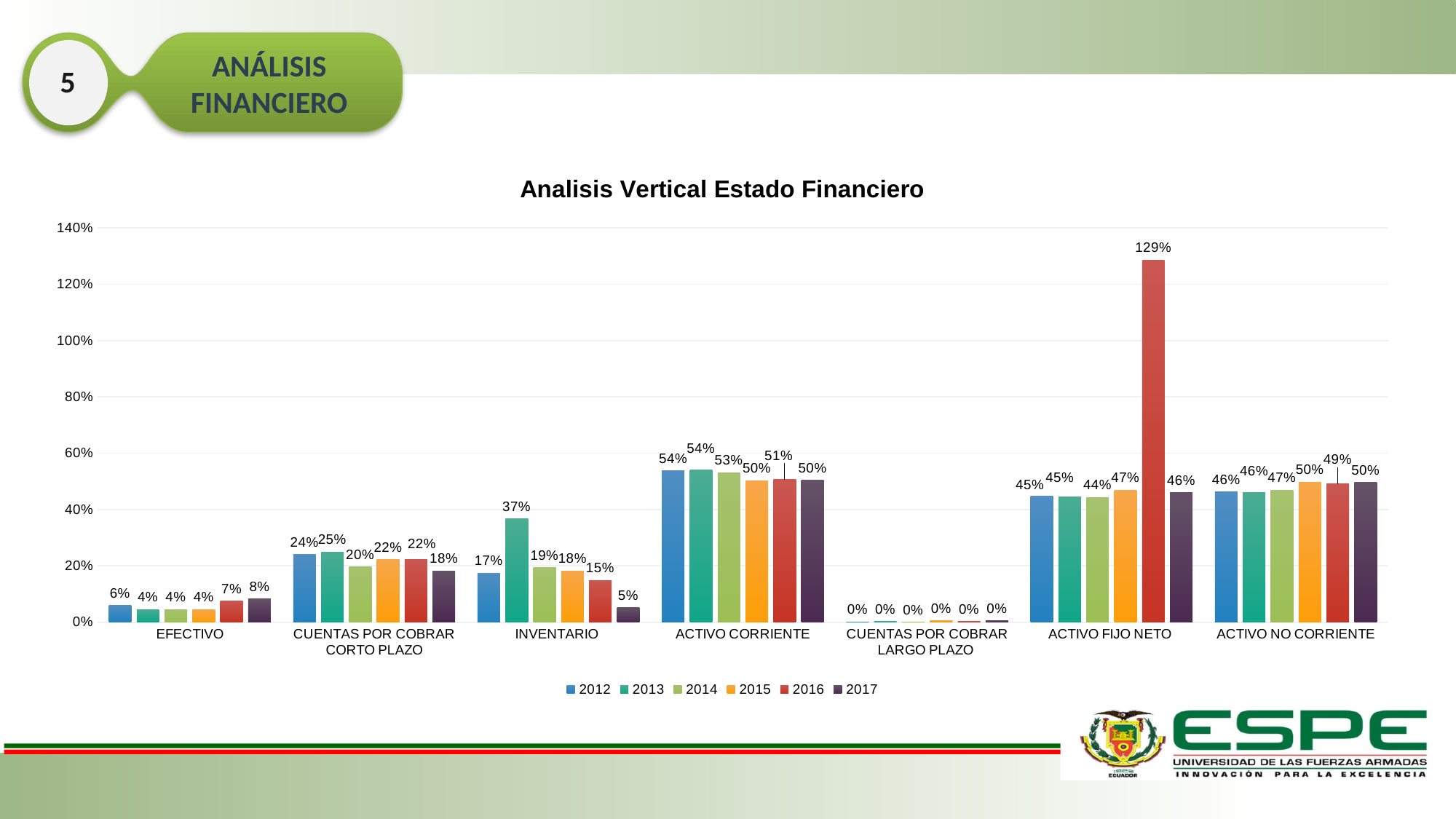
What is the value for INVENTARIO in 2013? 37% What kind of chart is shown on the slide? Bar chart What is the value for CUENTAS POR COBRAR CORTO PLAZO in 2014? 20% Which year has the lowest value for INVENTARIO? 2017 Which year has the highest value for INVENTARIO? 2013 What is the difference between the 2016 and 2017 values for ACTIVO FIJO NETO? 83% What is the value for ACTIVO FIJO NETO in 2016? 129% What is the value for EFECTIVO in 2017? 8% How many series does the legend list? 6 How many categories are shown on the x axis? 7 What is the title of the chart? Analisis Vertical Estado Financiero Which is larger for CUENTAS POR COBRAR CORTO PLAZO: the 2012 value or the 2017 value? 2012